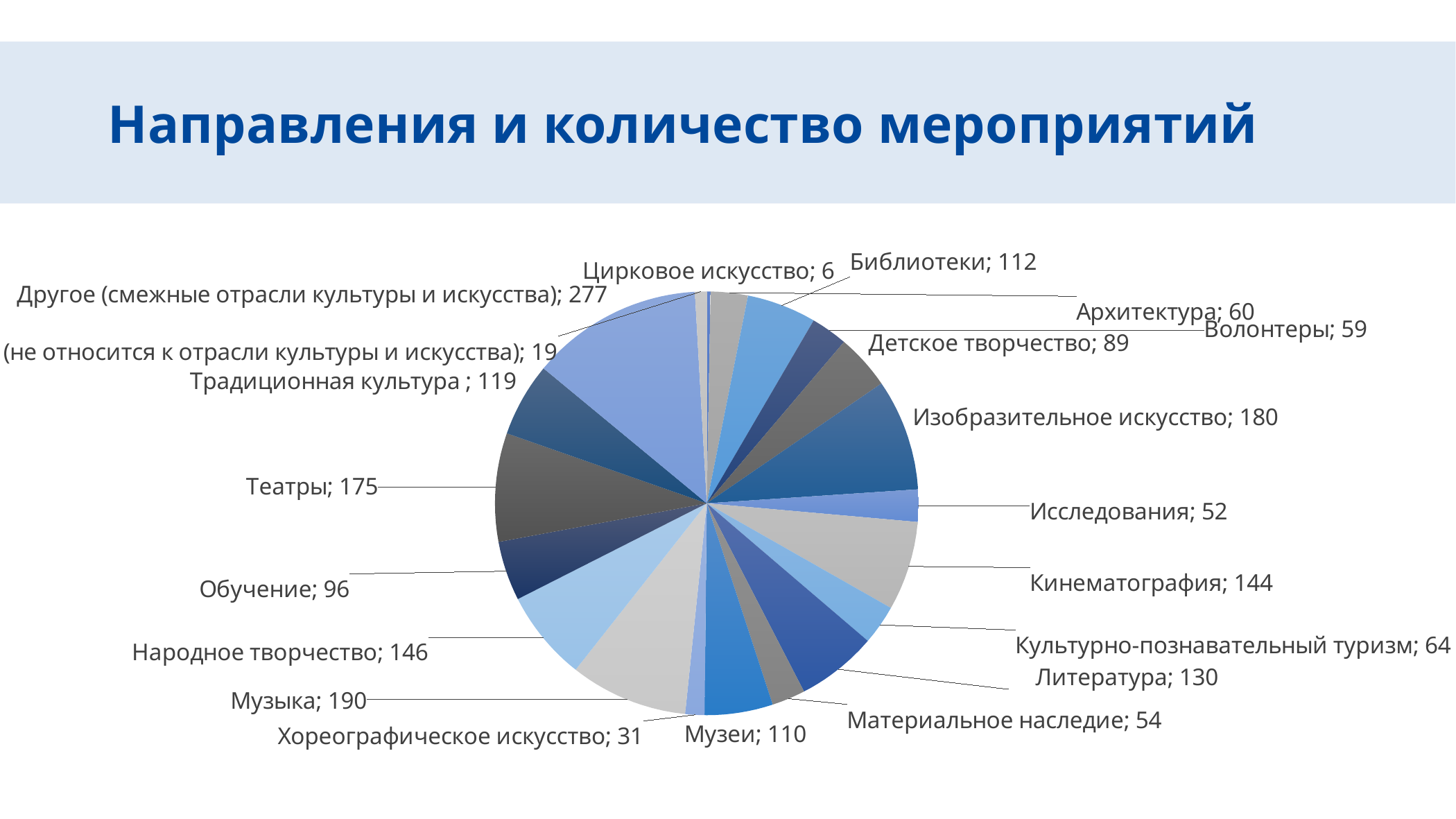
What is the title of the chart on the slide? Направления и количество мероприятий Which category has the highest value? Другое (смежные отрасли культуры и искусства) What is the value for Кинематография? 144 What is the difference between the values for Изобразительное искусство and Кинематография? 36 Which is larger, the value for Литература or the value for Народное творчество? Народное творчество What is the value for Хореографическое искусство? 31 What is the value for Музыка? 190 What is the value for Традиционная культура? 119 What is the difference between the values for Музыка and Театры? 15 How many categories (slices) does the pie chart have? 20 Which category has the lowest value? Цирковое искусство What kind of chart is shown on the slide? Pie chart